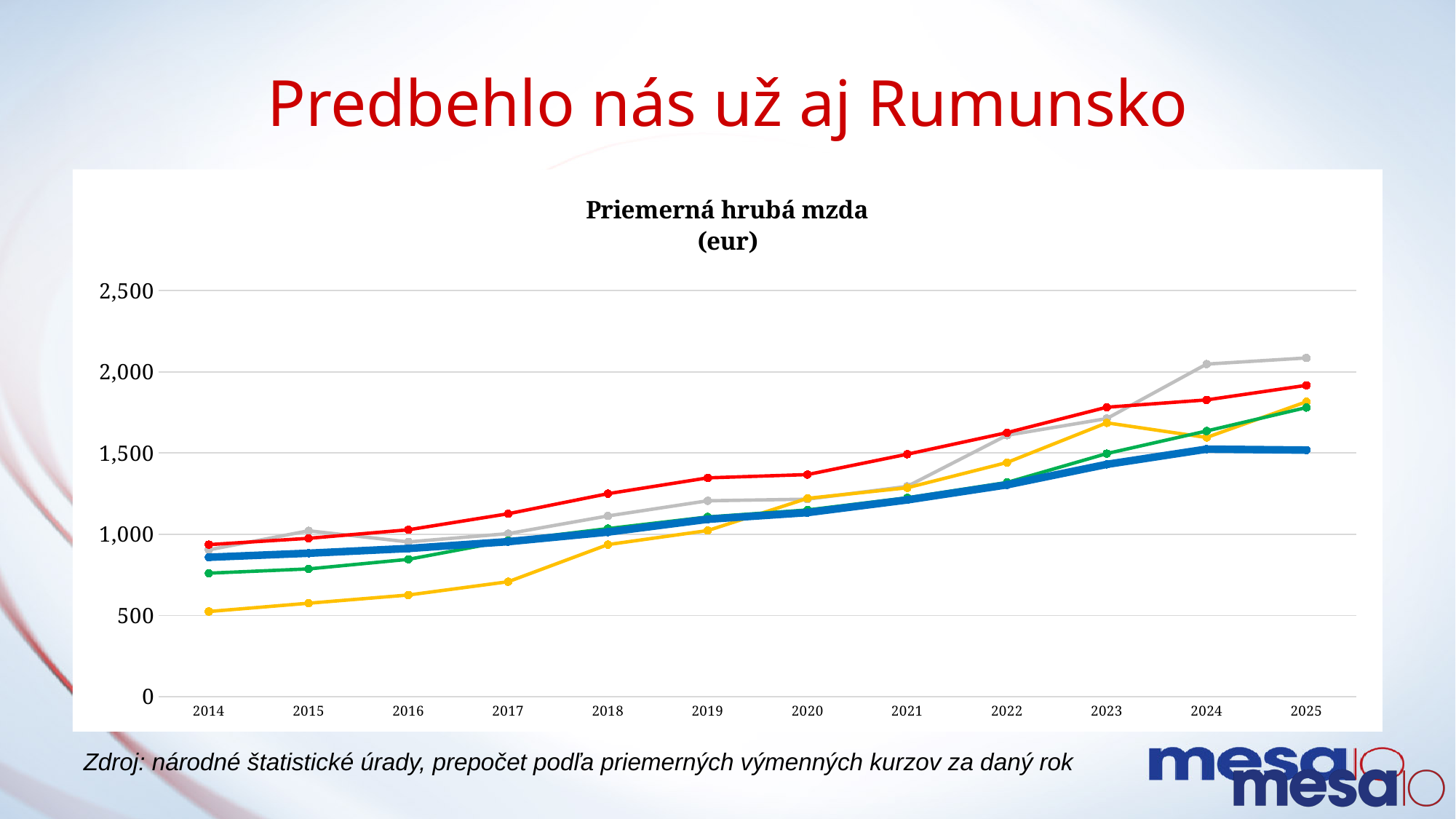
Which line has the highest value in 2025? the grey line How many years are shown on the x axis of the chart? 12 Is the value of the blue line in 2014 greater or less than 1,000? less Does the red line rise or fall from 2014 to 2025? rise How many lines are plotted on the chart? 5 In 2025, which is larger: the value of the red line or the value of the blue line? the red line Is the value of the red line in 2020 greater or less than 1,500? less Is the value of the grey line in 2025 greater or less than 2,000? greater What is the title of the chart? Priemerná hrubá mzda (eur) What kind of chart is shown on the slide? line chart Which line has the lowest value in 2014? the yellow line